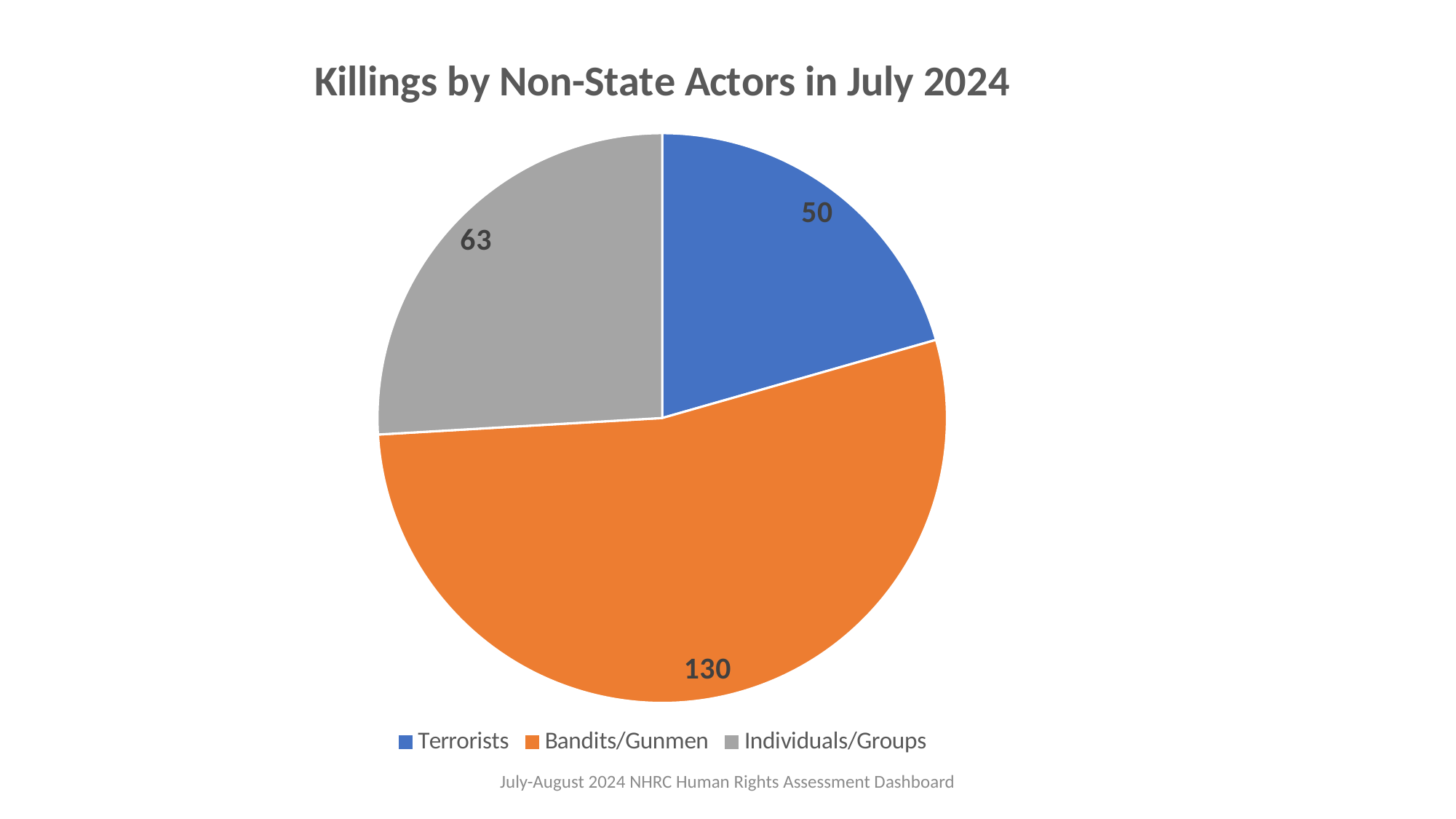
What kind of chart is shown on the slide? pie chart How many categories does the pie chart show? 3 What is the difference between the killings by Bandits/Gunmen and by Individuals/Groups? 67 Which is larger, the value for Individuals/Groups or the value for Terrorists? Individuals/Groups What is the title of the chart? Killings by Non-State Actors in July 2024 Which category accounts for the most killings? Bandits/Gunmen Which category accounts for the fewest killings? Terrorists What is the difference between the killings by Individuals/Groups and by Terrorists? 13 How many killings are attributed to Bandits/Gunmen? 130 How many killings are attributed to Terrorists? 50 What is the total number of killings across all three categories? 243 How many killings are attributed to Individuals/Groups? 63